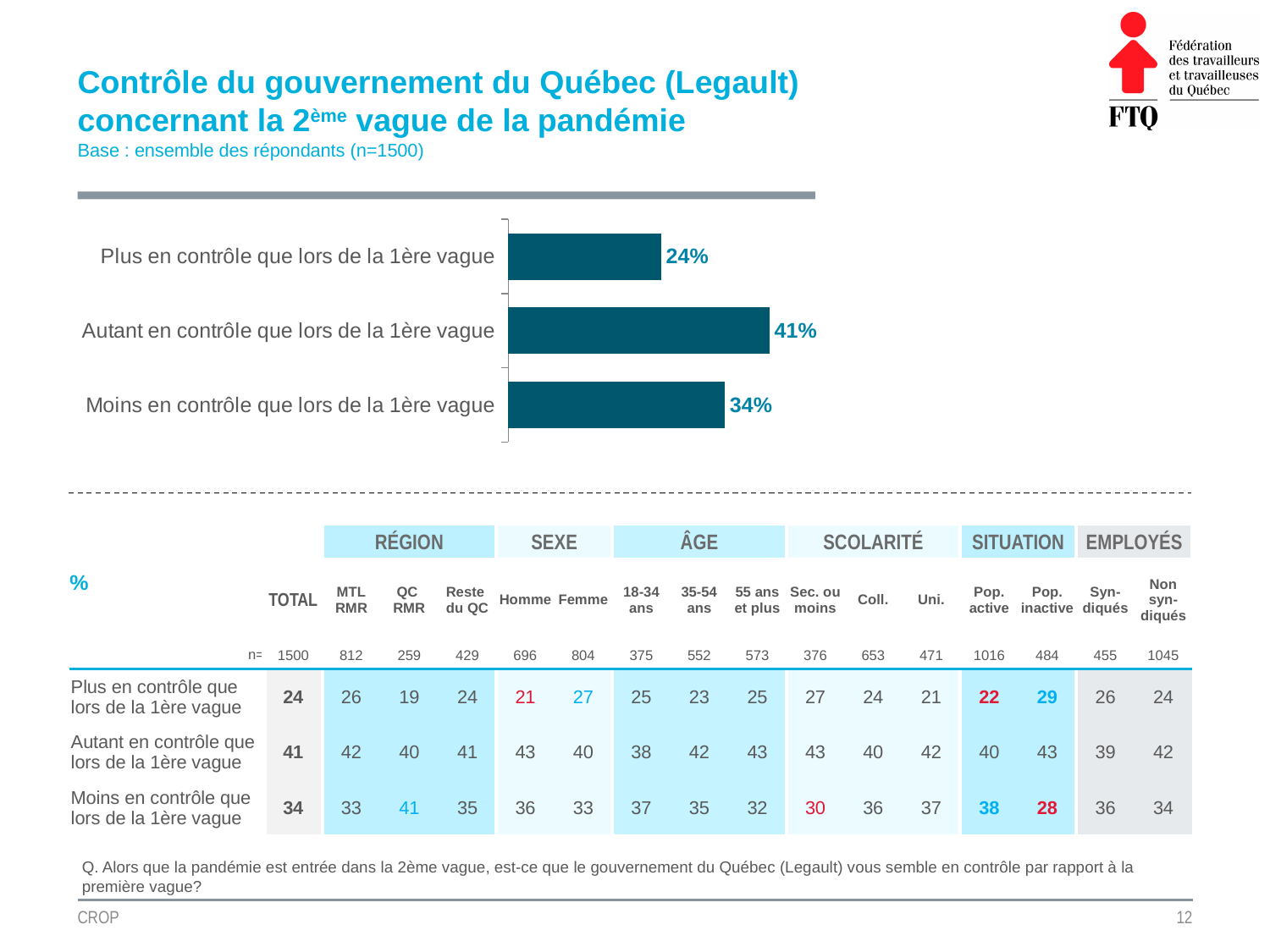
Which category has the lowest value? Plus en contrôle que lors de la 1ère vague What is the difference between "Autant en contrôle que lors de la 1ère vague" and "Plus en contrôle que lors de la 1ère vague"? 17% Which is larger: "Moins en contrôle que lors de la 1ère vague" or "Plus en contrôle que lors de la 1ère vague"? Moins en contrôle que lors de la 1ère vague What is the difference between "Autant en contrôle que lors de la 1ère vague" and "Moins en contrôle que lors de la 1ère vague"? 7% What is the total of the three values shown in the chart? 99% What is the value for "Moins en contrôle que lors de la 1ère vague"? 34% What is the base (n) of respondents stated under the chart title? n=1500 Which category has the highest value? Autant en contrôle que lors de la 1ère vague What kind of chart is shown on the slide? Bar chart What is the value for "Autant en contrôle que lors de la 1ère vague"? 41% What is the value for "Plus en contrôle que lors de la 1ère vague"? 24% How many categories are shown in the chart? 3